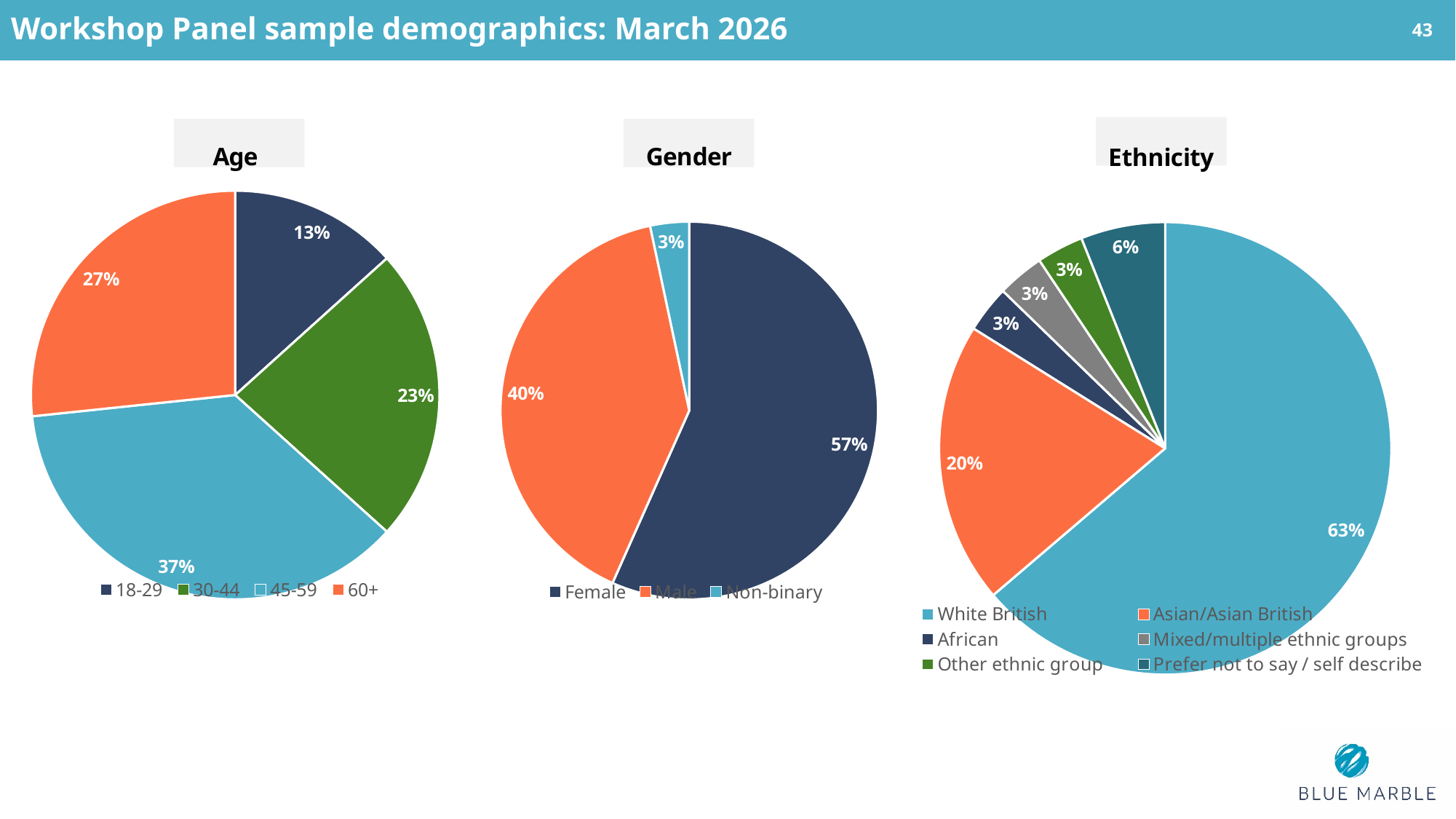
In the Age chart, what is the difference between the 60+ share and the 30-44 share? 4 percentage points In the Age chart, which age group has the largest share? 45-59 In the Ethnicity chart, what is the difference between the White British share and the Asian/Asian British share? 43 percentage points In the Ethnicity chart, what percentage is shown for Asian/Asian British? 20% In the Gender chart, which category has the smallest share? Non-binary In the Age chart, what share of the sample is aged 45-59? 37% In the Gender chart, what percentage of the sample is Female? 57% In the Ethnicity chart, how many categories does the legend list? 6 In the Gender chart, how many categories does the legend list? 3 In the Age chart, what percentage is shown for the 18-29 group? 13% What type of chart is used for the Gender breakdown? Pie chart In the Ethnicity chart, what share is White British? 63%